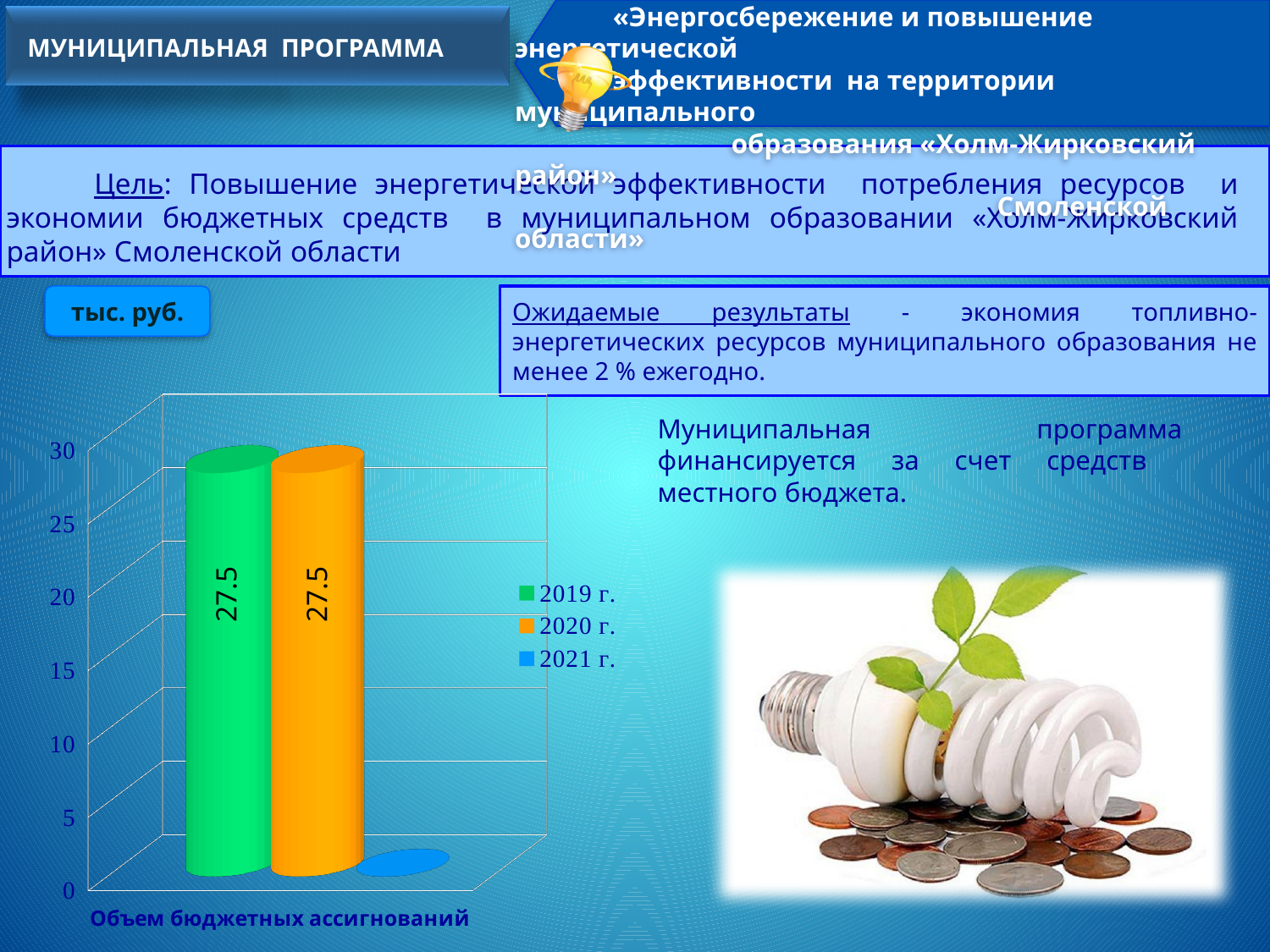
Which series has the lowest value in the chart? 2021 г. Is the value for 2020 г. greater or less than 30? less How many series does the legend list? 3 What kind of chart is shown on the slide? bar chart Is the value for 2021 г. greater or less than 5? less What is the value for the 2019 г. series in the chart? 27.5 What is the value for the 2020 г. series in the chart? 27.5 What is the difference between the values for 2019 г. and 2020 г.? 0 What unit is indicated for the chart values? тыс. руб. Is the value for 2019 г. greater or less than 25? greater Which series is shown in orange in the chart? 2020 г. What is the category label shown below the chart? Объем бюджетных ассигнований